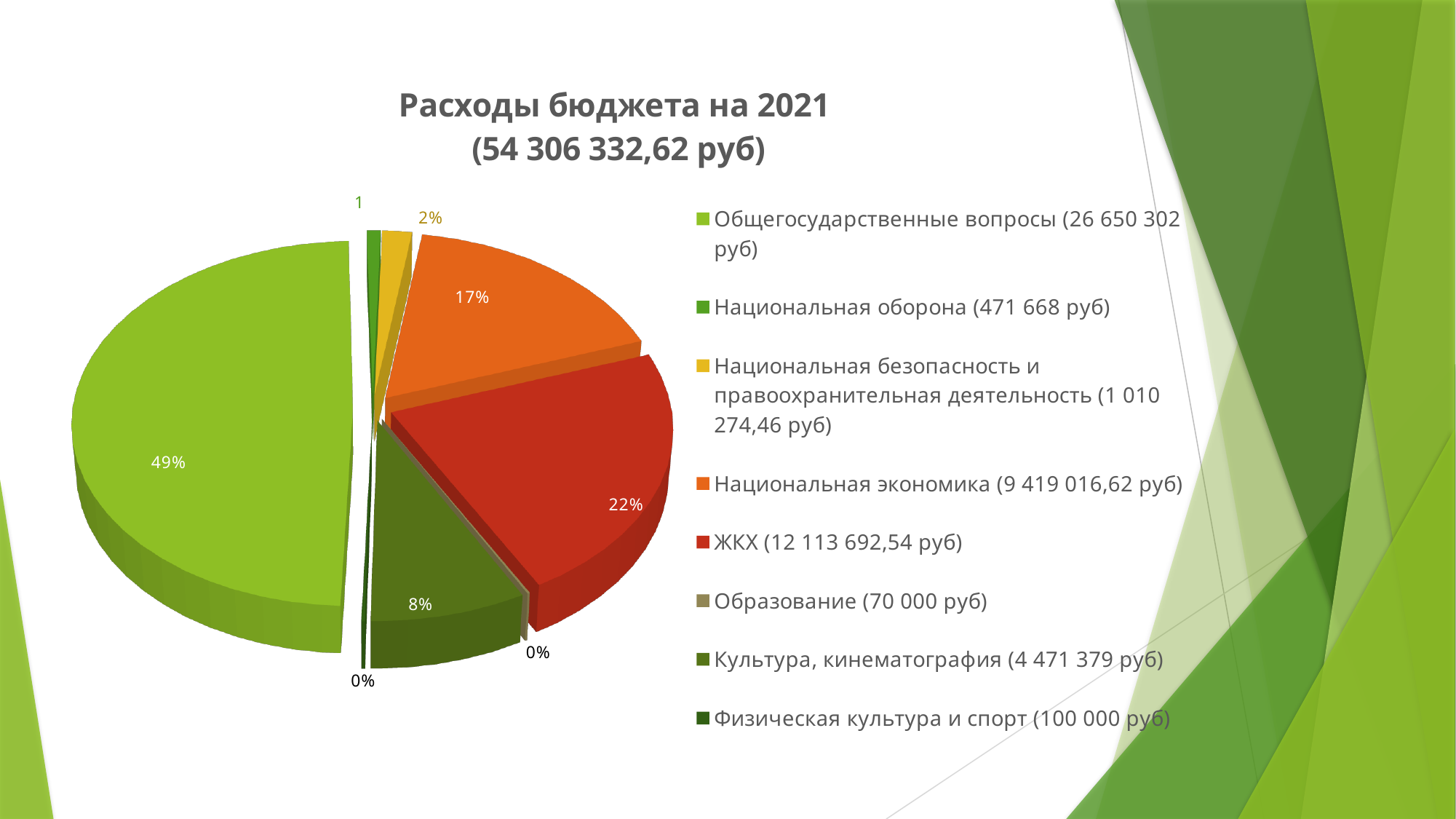
What share of the pie does Национальная безопасность и правоохранительная деятельность take? 2% What kind of chart is shown on the slide? pie chart What share of the pie does Культура, кинематография take? 8% Which is larger, the slice for ЖКХ or the slice for Национальная экономика? ЖКХ What is the title of the chart? Расходы бюджета на 2021 (54 306 332,62 руб) What share of the pie does Общегосударственные вопросы take? 49% Which category has the largest slice of the pie? Общегосударственные вопросы What amount in rubles is shown in the legend for Национальная оборона? 471 668 руб What is the difference in percentage points between the ЖКХ slice and the Культура, кинематография slice? 14 How many categories does the legend of the pie chart list? 8